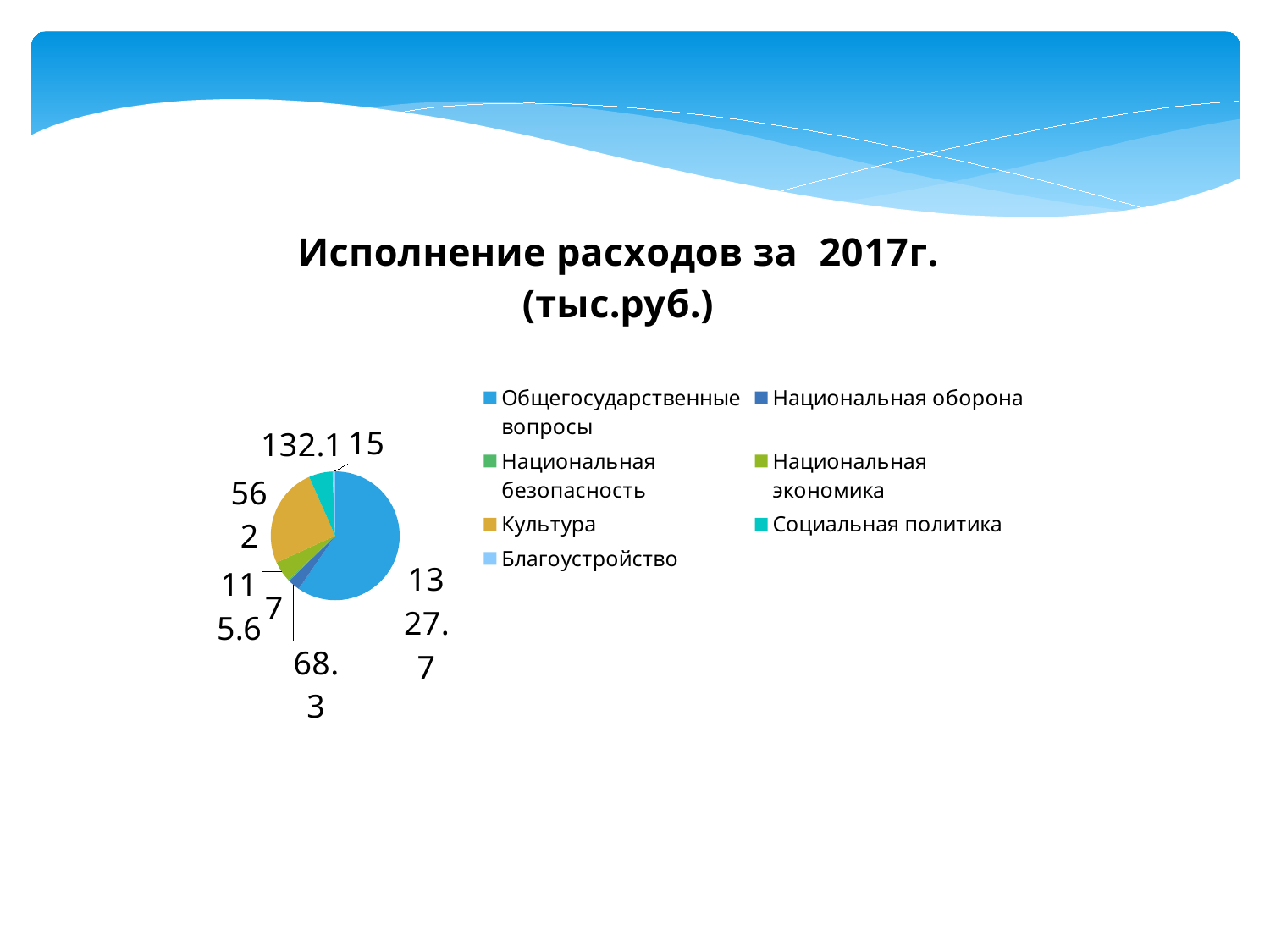
How many categories does the pie chart have? 7 What is the value for Культура? 562 What is the value for Благоустройство? 15 Which category has the largest slice of the pie? Общегосударственные вопросы What is the difference between the values for Социальная политика and Благоустройство? 117.1 Which is larger, Культура or Социальная политика? Культура Which category has the smallest slice of the pie? Национальная безопасность What is the title of the chart? Исполнение расходов за 2017г. (тыс.руб.) What is the value for Социальная политика? 132.1 What is the value for Национальная безопасность? 7 Which is larger, Национальная оборона or Национальная безопасность? Национальная оборона What kind of chart is shown on the slide? pie chart